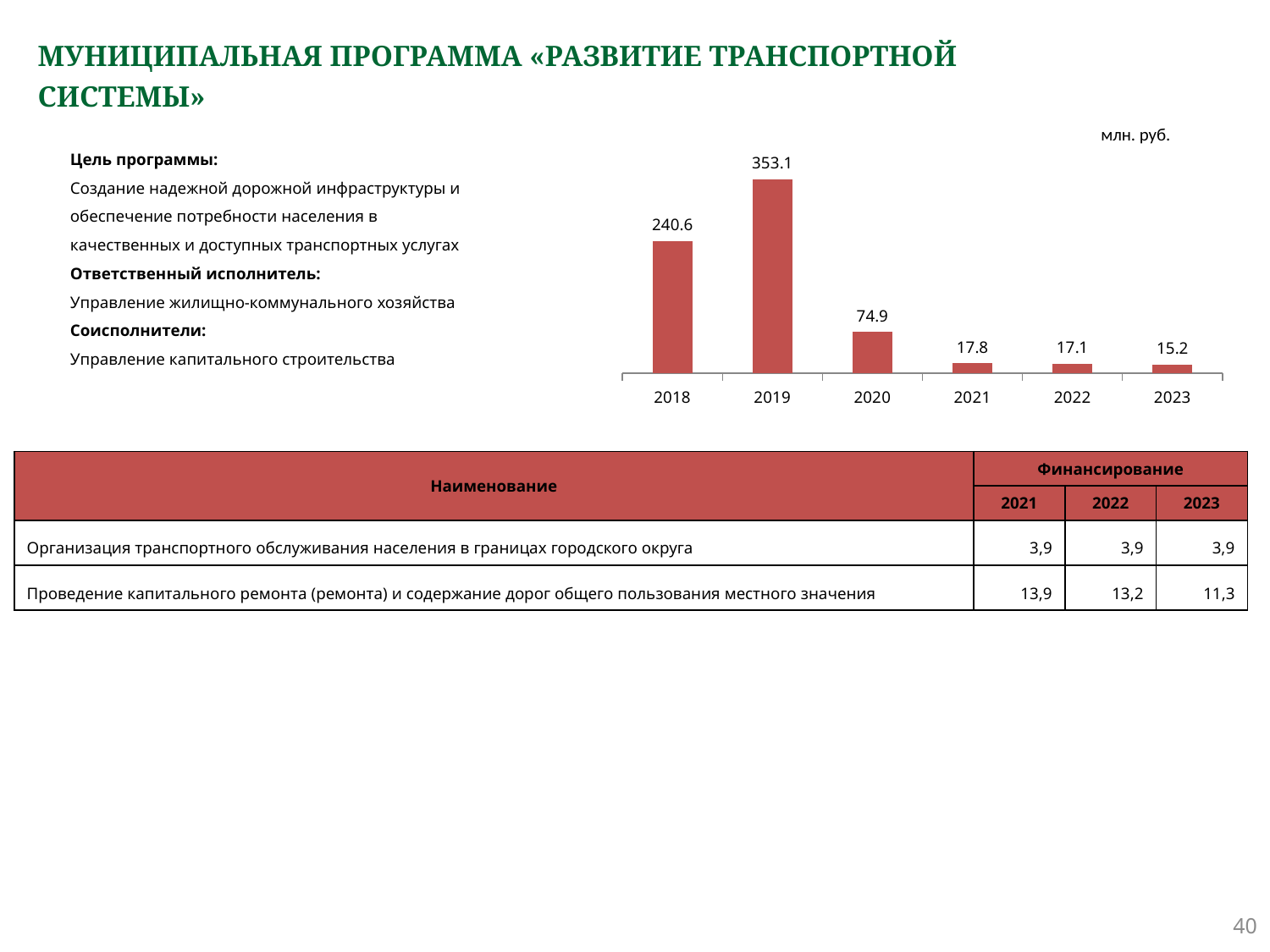
Which year has the highest value in the bar chart? 2019 What is the value shown for 2021 in the bar chart? 17.8 What is the difference between the values for 2019 and 2018 in the bar chart? 112.5 What unit is indicated above the bar chart? млн. руб. Which year has the lowest value in the bar chart? 2023 What type of chart is shown on the slide? bar chart What is the difference between the values for 2020 and 2021 in the bar chart? 57.1 Do the values in the bar chart rise or fall from 2019 to 2023? fall What is the value shown for 2019 in the bar chart? 353.1 Which is larger in the bar chart, the value for 2018 or the value for 2020? 2018 What is the value shown for 2023 in the bar chart? 15.2 How many years are shown on the x axis of the bar chart? 6